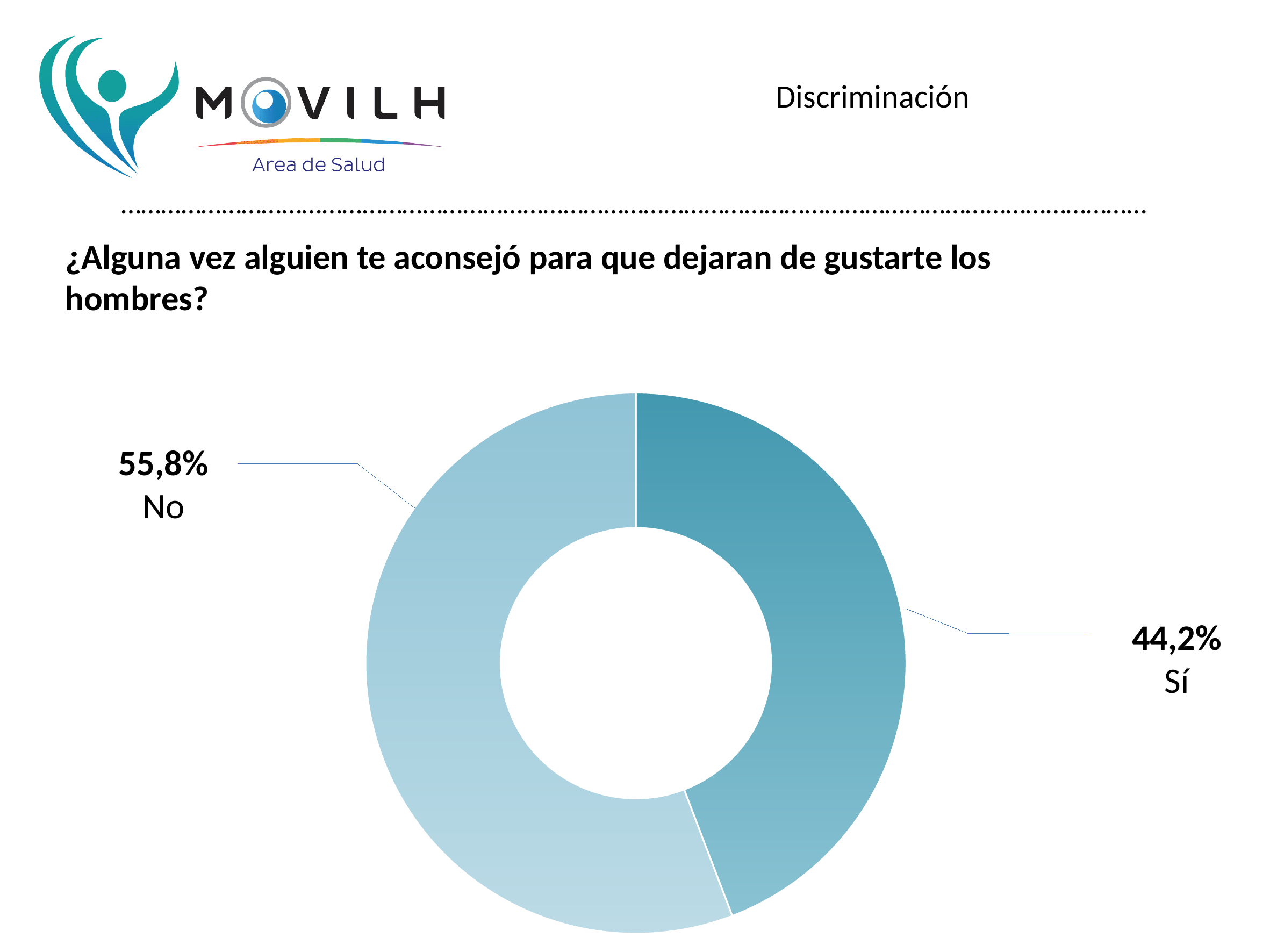
What is the difference in percentage points between the "No" and "Sí" shares? 11,6 What question does the chart on the slide answer? ¿Alguna vez alguien te aconsejó para que dejaran de gustarte los hombres? Which category is shown in the darker blue segment? Sí Which category has the largest share of the chart? No What is the total of the two shares shown in the chart? 100% How many categories are shown in the chart? 2 Which category has the smallest share of the chart? Sí What percentage of respondents answered "No"? 55,8% What percentage of respondents answered "Sí"? 44,2% Which response has the larger share, "Sí" or "No"? No What kind of chart is shown on the slide? Doughnut chart